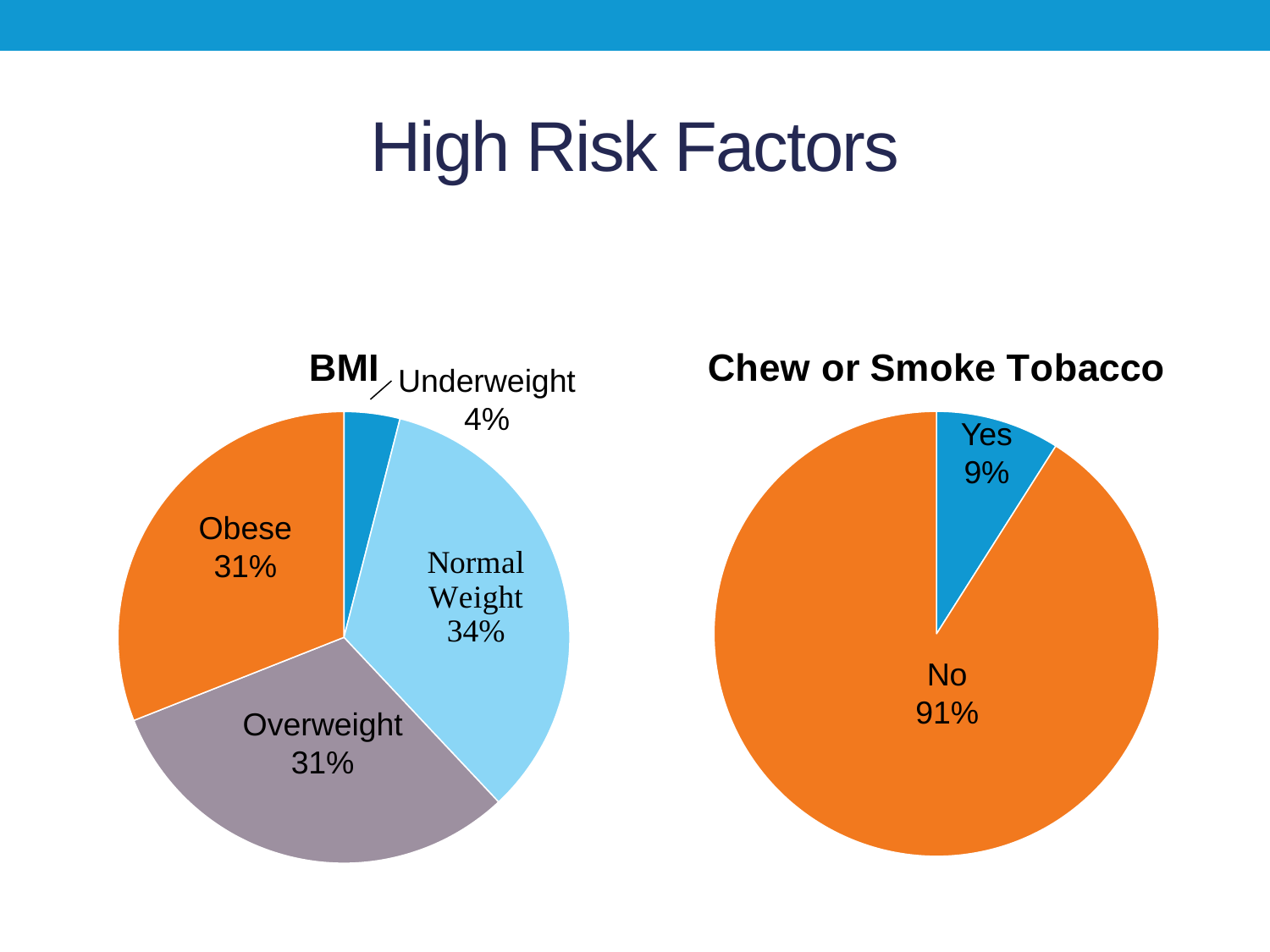
In the BMI chart, which category has the smallest slice? Underweight In the Chew or Smoke Tobacco chart, what percentage answered No? 91% In the Chew or Smoke Tobacco chart, what is the difference in percentage points between No and Yes? 82 In the Chew or Smoke Tobacco chart, which slice is larger, Yes or No? No What kind of chart is the BMI chart? Pie chart In the BMI chart, what percentage is labelled for Underweight? 4% In the BMI chart, which category has the largest slice? Normal Weight What is the title of the chart on the right side of the slide? Chew or Smoke Tobacco In the Chew or Smoke Tobacco chart, what percentage answered Yes? 9% In the BMI chart, what percentage is labelled for Normal Weight? 34% In the BMI chart, how many categories are shown? 4 In the BMI chart, what is the difference in percentage points between Normal Weight and Obese? 3